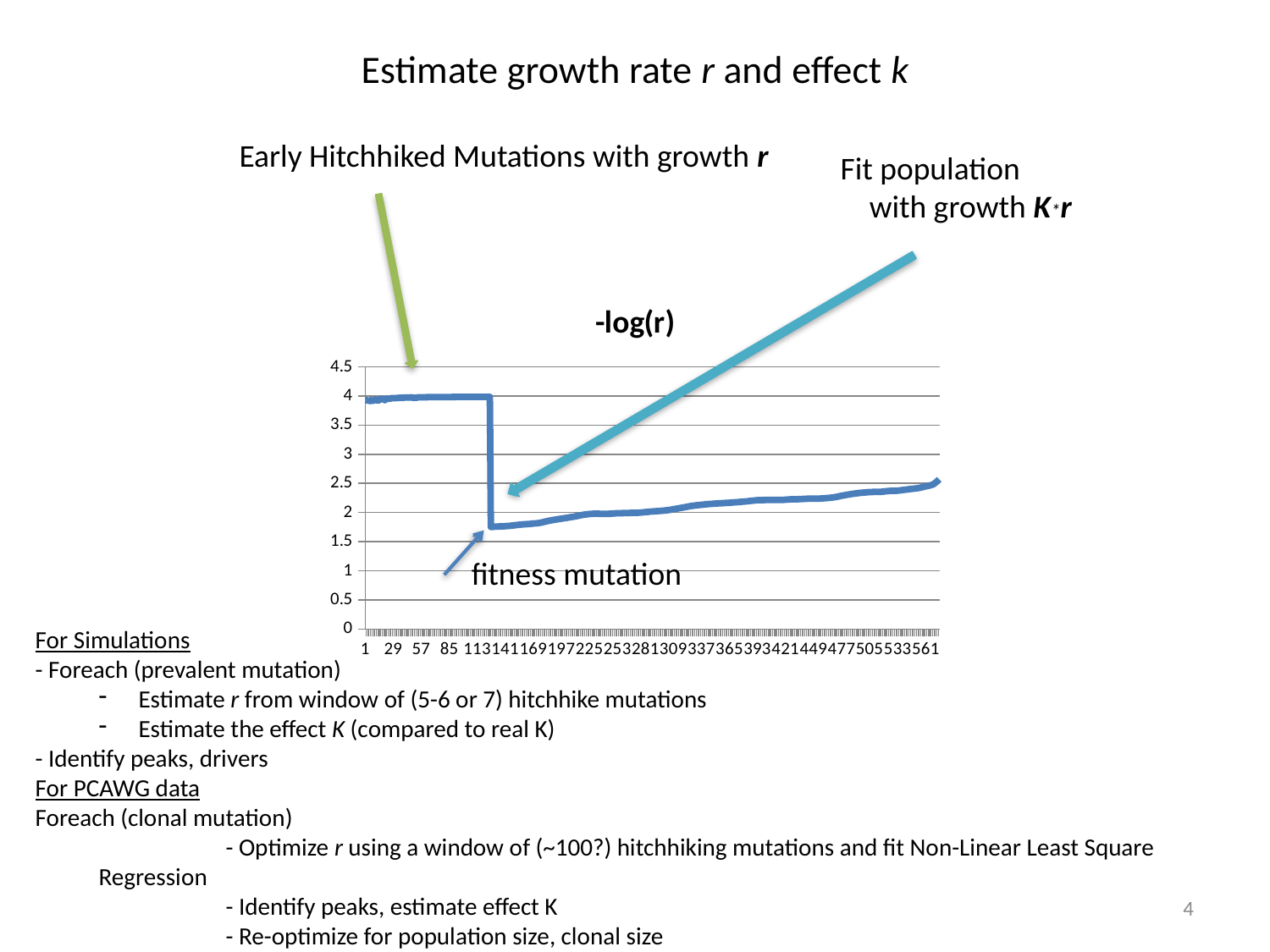
Is the value of -log(r) at x = 85 greater or less than 3? greater Is the value of -log(r) at x = 1 greater or less than 3.5? greater What kind of chart is shown on the slide? line chart What is the highest tick value shown on the y axis of the chart? 4.5 Which is larger, the value of -log(r) at x = 57 or at x = 281? x = 57 Is the value of -log(r) at x = 561 greater or less than 3? less What is the title of the chart? -log(r) After the sharp drop near x = 113, do the values of -log(r) rise or fall as x increases? rise